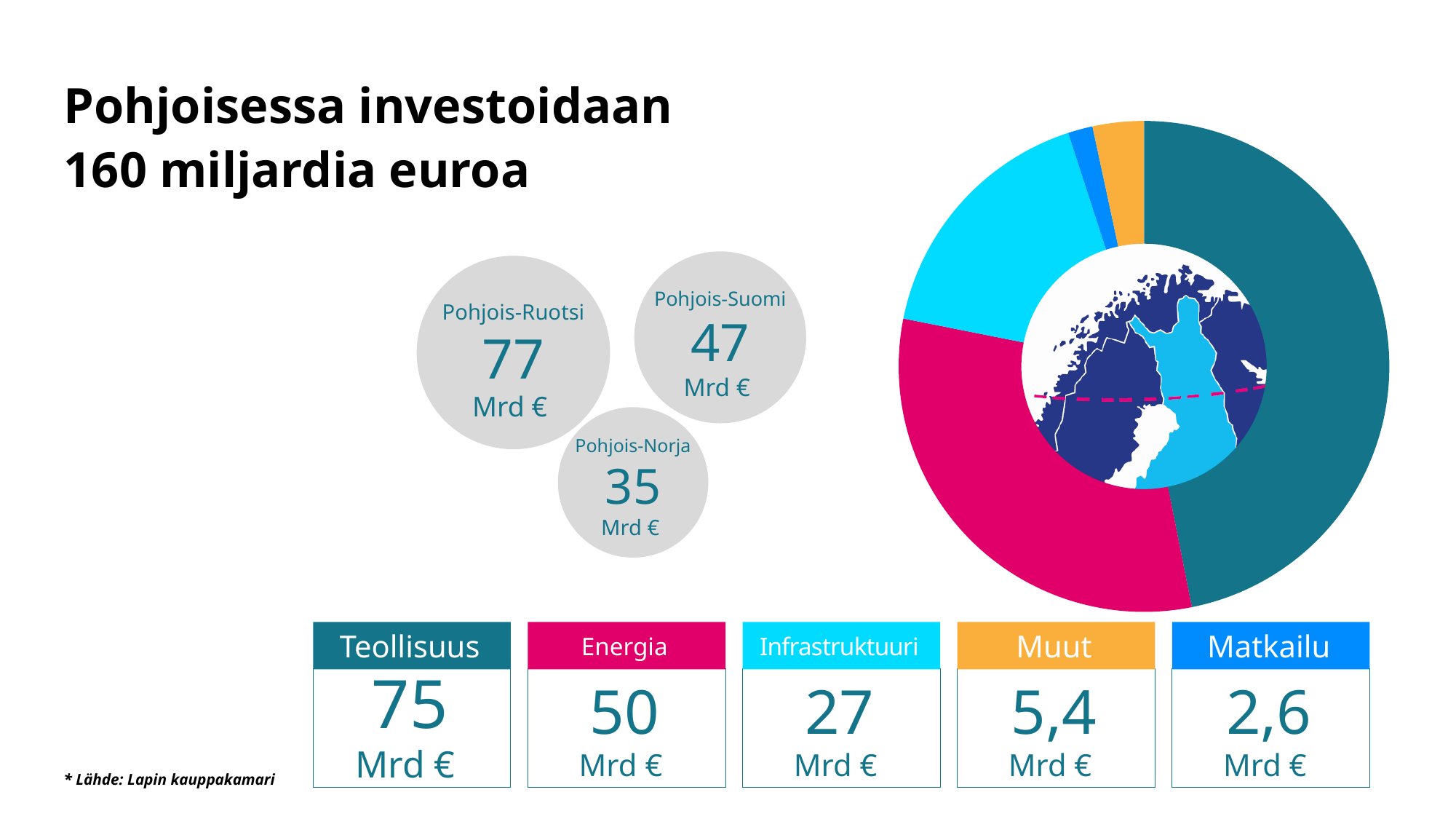
What kind of chart is shown on the right of the slide? Pie (donut) chart What is the total of all five categories in the donut chart? 160 Mrd € What colour represents Energia in the donut chart? Pink (magenta) What is the value for Infrastruktuuri in the donut chart? 27 Mrd € What is the value for Energia in the donut chart? 50 Mrd € Which category has the largest share of the donut chart? Teollisuus What is the difference between the values for Teollisuus and Energia in the donut chart? 25 Mrd € What is the value for Teollisuus in the donut chart? 75 Mrd € Which category has the smallest share of the donut chart? Matkailu Which is larger in the donut chart, Muut or Matkailu? Muut What is the value for Matkailu in the donut chart? 2,6 Mrd € How many categories does the donut chart show? 5